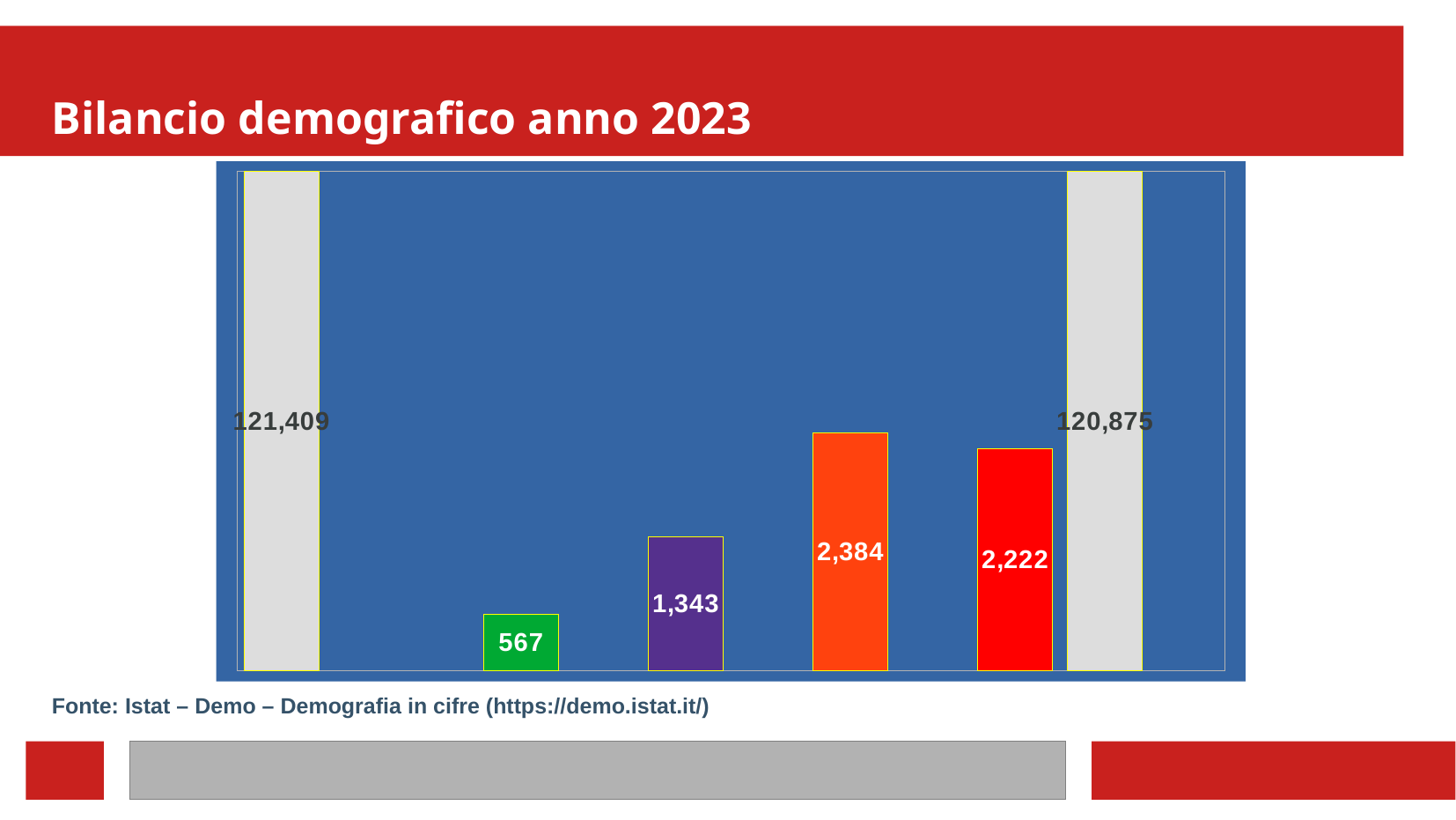
What is the value shown on the red bar? 2,222 How many bars are plotted in the chart? 6 What is the value of the leftmost grey bar? 121,409 What is the value of the rightmost grey bar? 120,875 Which bar has the highest value? the leftmost grey bar (121,409) What kind of chart is shown on the slide? bar chart Which bar has the lowest value? the green bar (567) What is the value shown on the orange bar? 2,384 What is the value shown on the purple bar? 1,343 What is the value shown on the green bar? 567 What is the difference between the orange bar and the red bar? 162 What is the title of the slide containing the chart? Bilancio demografico anno 2023